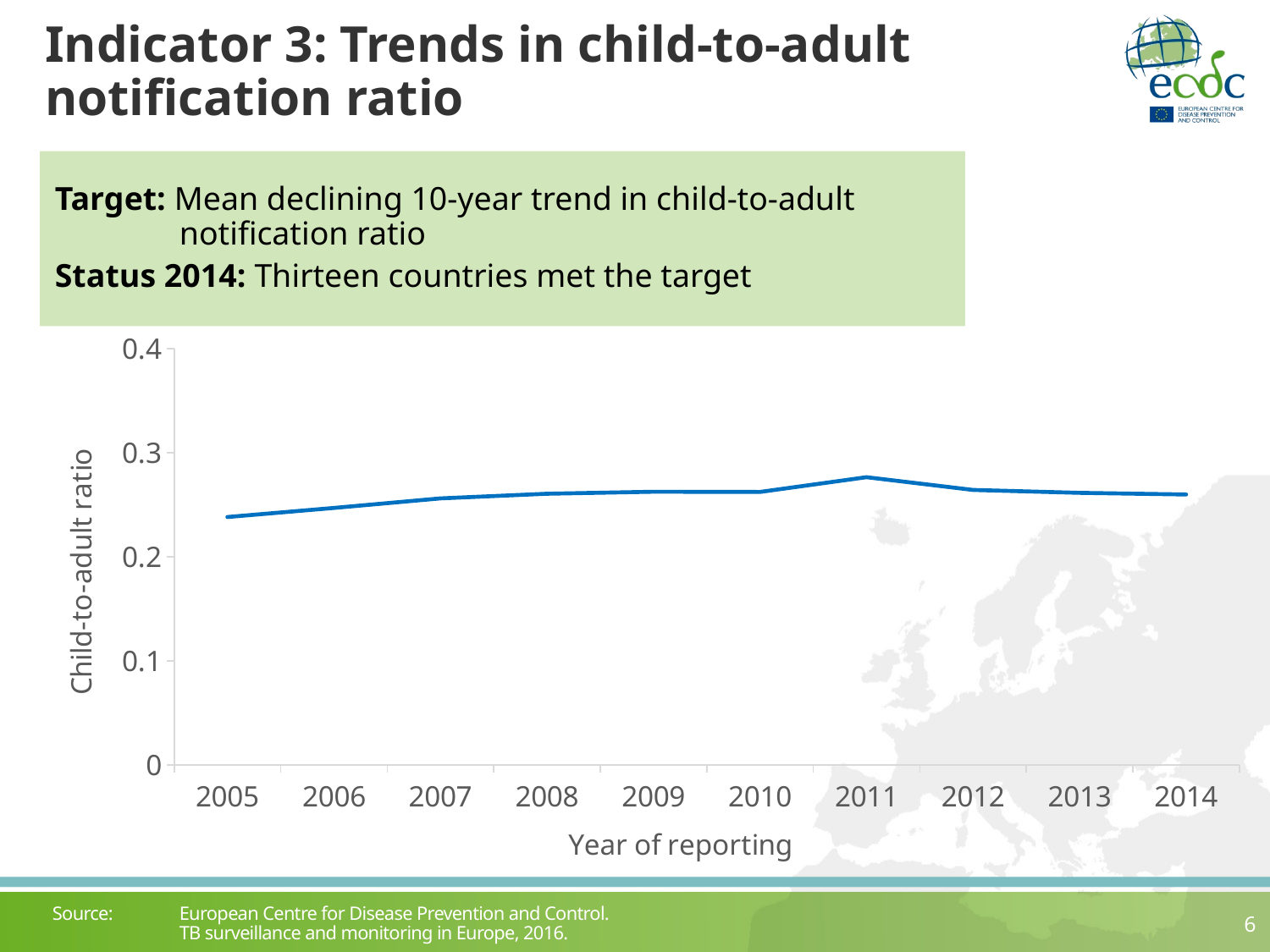
In which year of reporting is the child-to-adult ratio highest? 2011 Is the child-to-adult ratio for 2011 greater or less than 0.3? less Does the child-to-adult ratio rise or fall from 2005 to 2011? Rise What kind of chart is shown on the slide? Line chart How many years are plotted on the x axis of the chart? 10 Is the child-to-adult ratio for 2005 greater or less than 0.2? greater Which year has the larger child-to-adult ratio, 2005 or 2011? 2011 Which year has the larger child-to-adult ratio, 2005 or 2014? 2014 In which year of reporting is the child-to-adult ratio lowest? 2005 What is the label of the x axis of the chart? Year of reporting What is the label of the y axis of the chart? Child-to-adult ratio Is the child-to-adult ratio for 2014 greater or less than 0.3? less